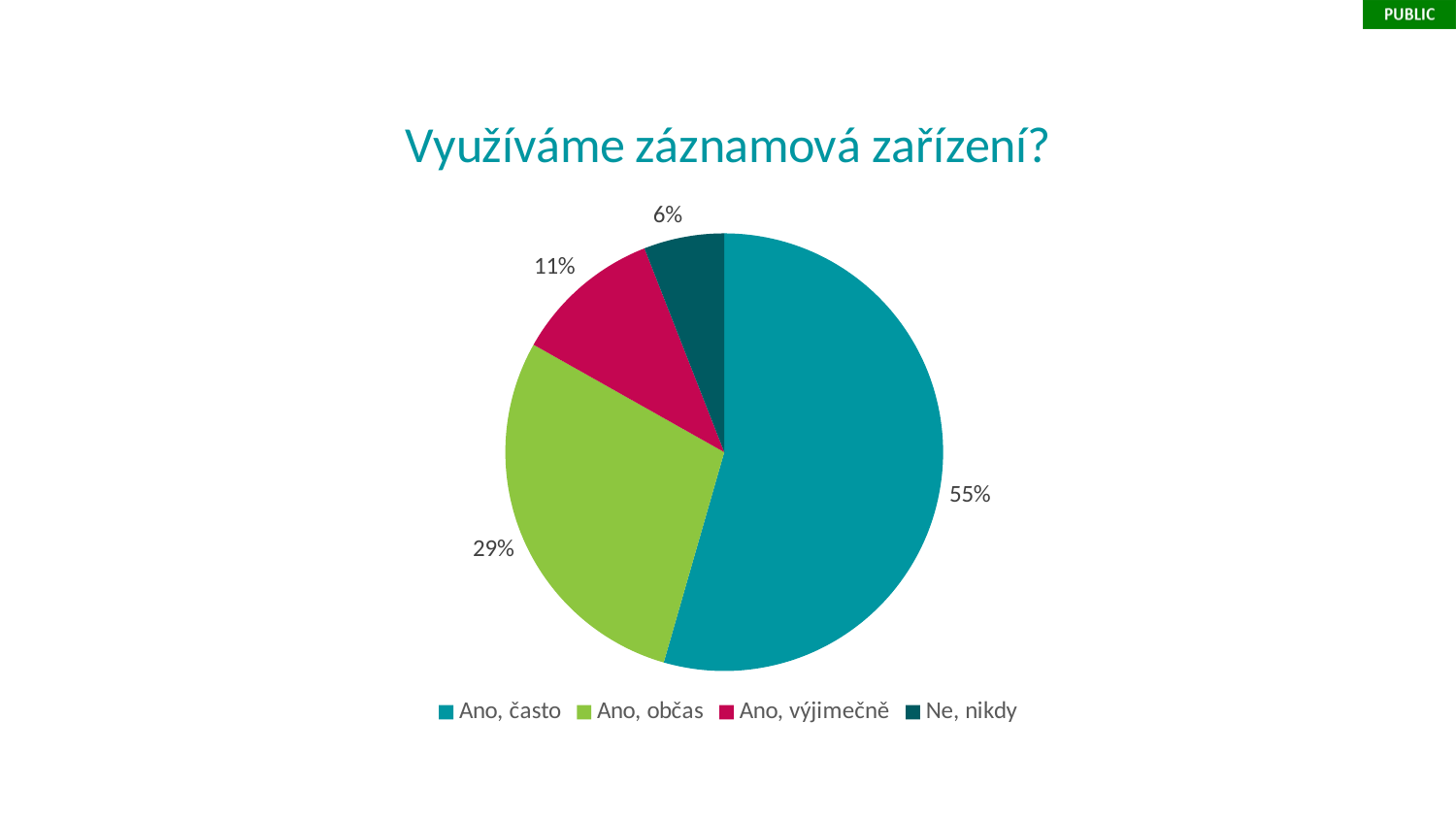
What percentage of the pie is labelled "Ano, občas"? 29% What percentage of the pie is labelled "Ano, často"? 55% Which category has the smallest share of the pie? Ne, nikdy Which category has the largest share of the pie? Ano, často Which is larger, the share for "Ano, výjimečně" or the share for "Ne, nikdy"? Ano, výjimečně What is the title of the chart? Využíváme záznamová zařízení? What type of chart is shown on the slide? pie chart What colour is the slice for "Ano, občas"? green What is the difference in percentage points between "Ano, často" and "Ano, občas"? 26 How many categories does the legend list? 4 What percentage of the pie is labelled "Ano, výjimečně"? 11% What percentage of the pie is labelled "Ne, nikdy"? 6%